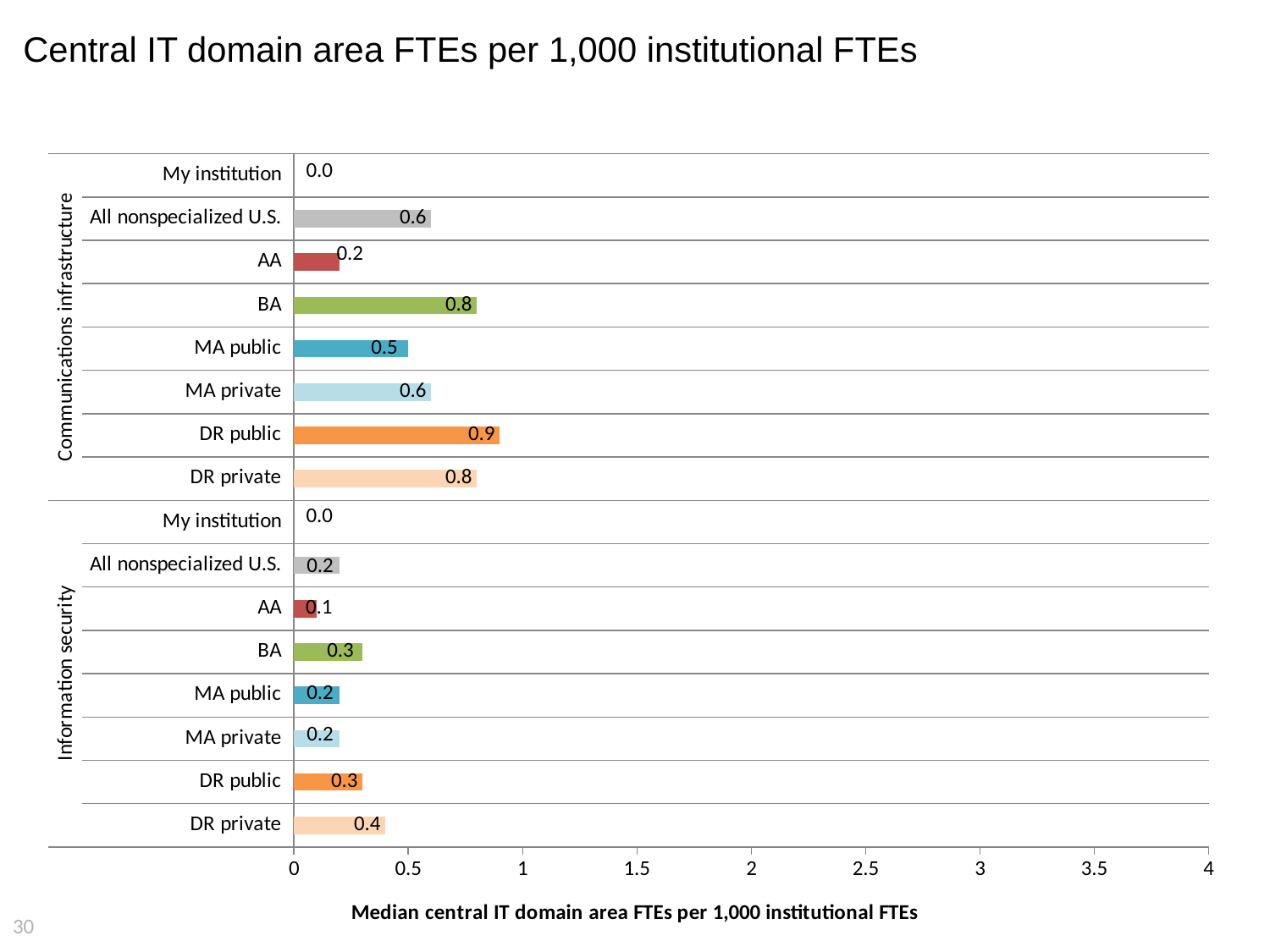
How many domain area groups are shown on the chart? 2 Is the value for BA under Communications infrastructure greater or less than 0.5? greater Which category has the highest value under Communications infrastructure? DR public What type of chart is shown on the slide? Bar chart Which is larger under Communications infrastructure: MA public or MA private? MA private What is the value for BA under Communications infrastructure? 0.8 Excluding My institution, which category has the lowest value under Information security? AA What is the difference between DR private and BA under Information security? 0.1 What is the value for DR public under Communications infrastructure? 0.9 Which category has the highest value under Information security? DR private What is the difference between DR public and AA under Communications infrastructure? 0.7 What is the value for All nonspecialized U.S. under Information security? 0.2